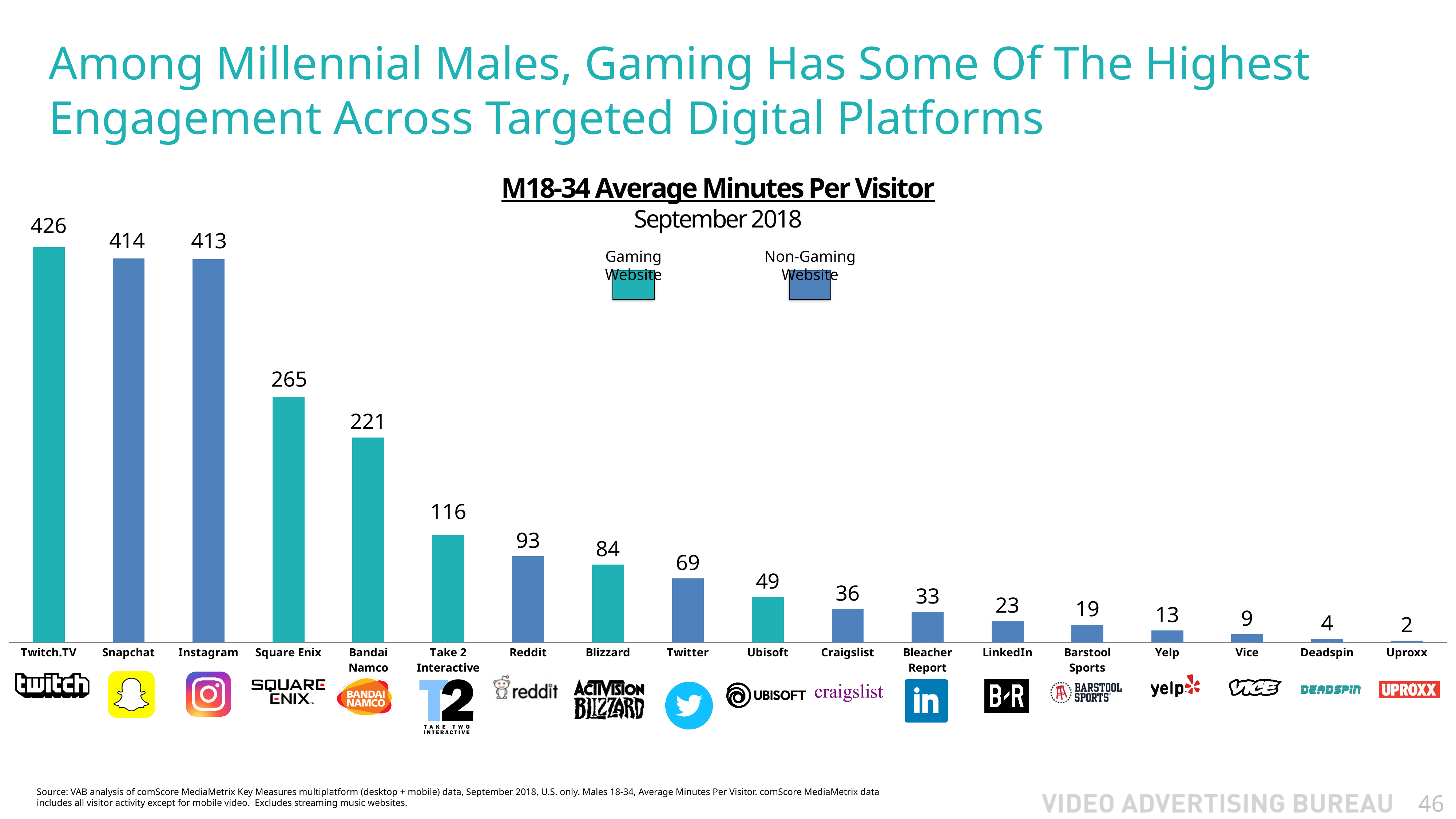
What is the average minutes per visitor for Twitch.TV? 426 How many series does the legend list? 2 Which platform has the highest average minutes per visitor? Twitch.TV Which has a higher average minutes per visitor, Blizzard or Twitter? Blizzard Which platform has the lowest average minutes per visitor? Uproxx How many platforms are shown in the chart? 18 Do the values rise or fall moving from left to right along the x axis? Fall Which legend category does the teal colour represent? Gaming Website What is the average minutes per visitor for Bandai Namco? 221 What is the difference in average minutes per visitor between Square Enix and Bandai Namco? 44 What is the average minutes per visitor for Reddit? 93 What kind of chart is shown on the slide? Bar chart